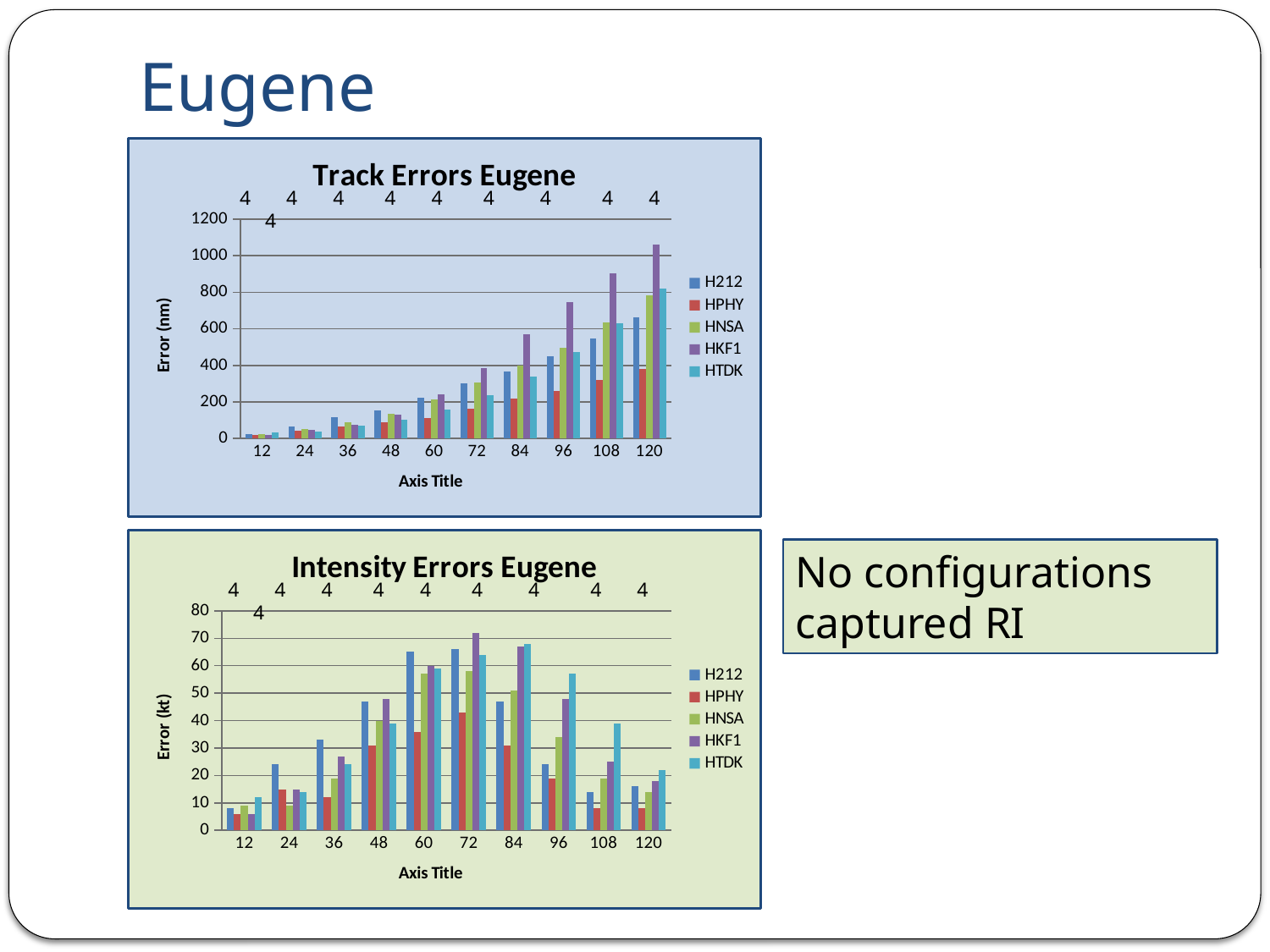
In the Intensity Errors Eugene chart, which series has the highest value at 72? HKF1 In the Intensity Errors Eugene chart, is the value for HPHY at 108 greater or less than 10? less What is the y-axis label of the Intensity Errors Eugene chart? Error (kt) In the Track Errors Eugene chart, which series has the highest value at 120? HKF1 In the Track Errors Eugene chart, which is larger at 120: H212 or HNSA? HNSA How many categories are shown on the x axis of the Track Errors Eugene chart? 10 In the Track Errors Eugene chart, is the value for HKF1 at 120 greater or less than 1000? greater In the Track Errors Eugene chart, do the H212 values rise or fall as the x axis goes from 12 to 120? rise What kind of chart is the Track Errors Eugene chart? bar chart In the Track Errors Eugene chart, which series has the lowest value at 120? HPHY How many series does the legend of the Intensity Errors Eugene chart list? 5